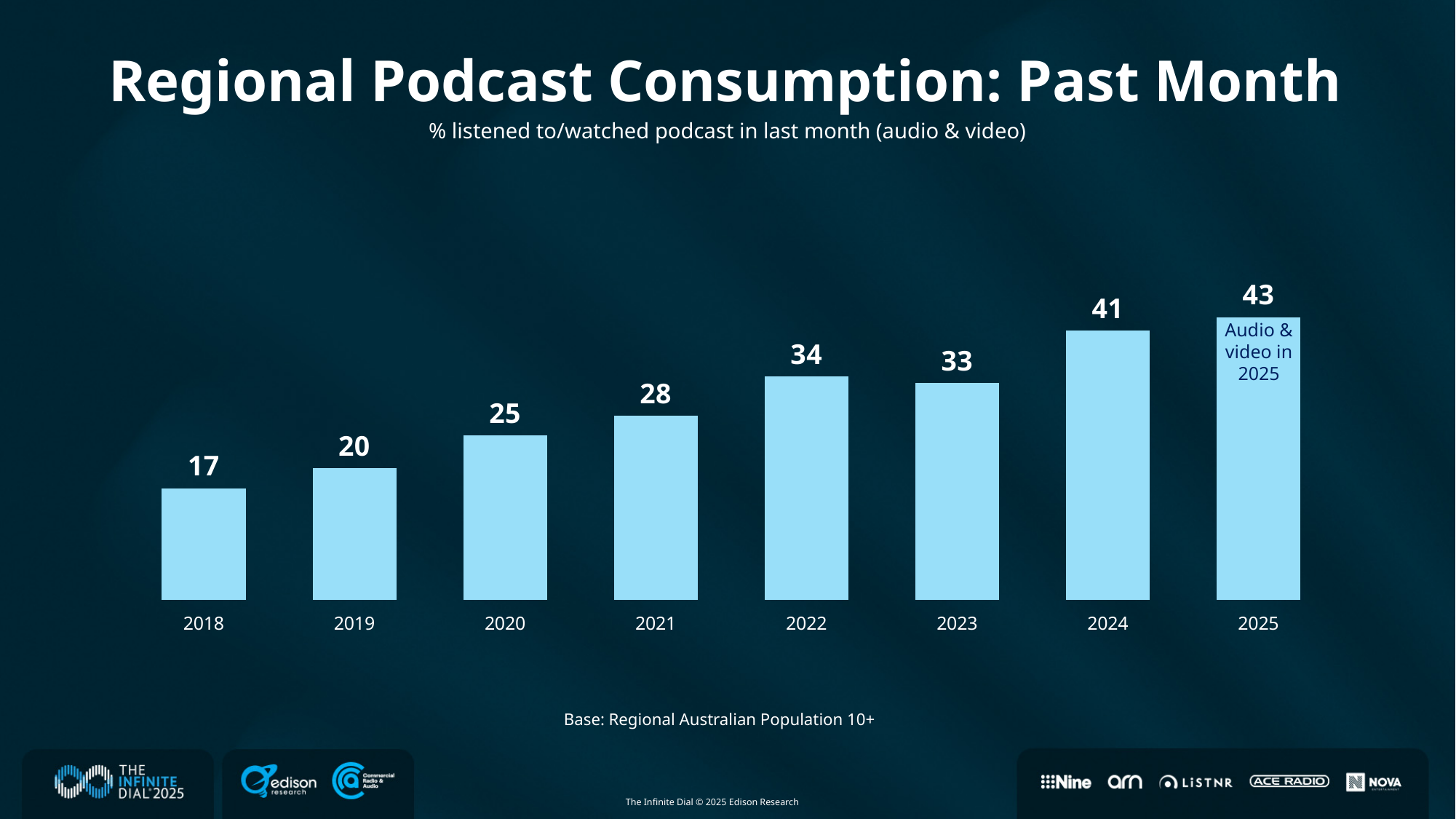
Which is larger, the value for 2022 or the value for 2023? 2022 What kind of chart is shown on the slide? Bar chart Do the values generally rise or fall from 2018 to 2025? Rise Which year has the lowest value? 2018 What is the value for 2025? 43 What is the difference between the values for 2024 and 2023? 8 How many years are shown on the chart? 8 What is the title of the chart? Regional Podcast Consumption: Past Month Which year has the highest value? 2025 What is the difference between the values for 2025 and 2018? 26 What is the value for 2022? 34 What is the value for 2018? 17